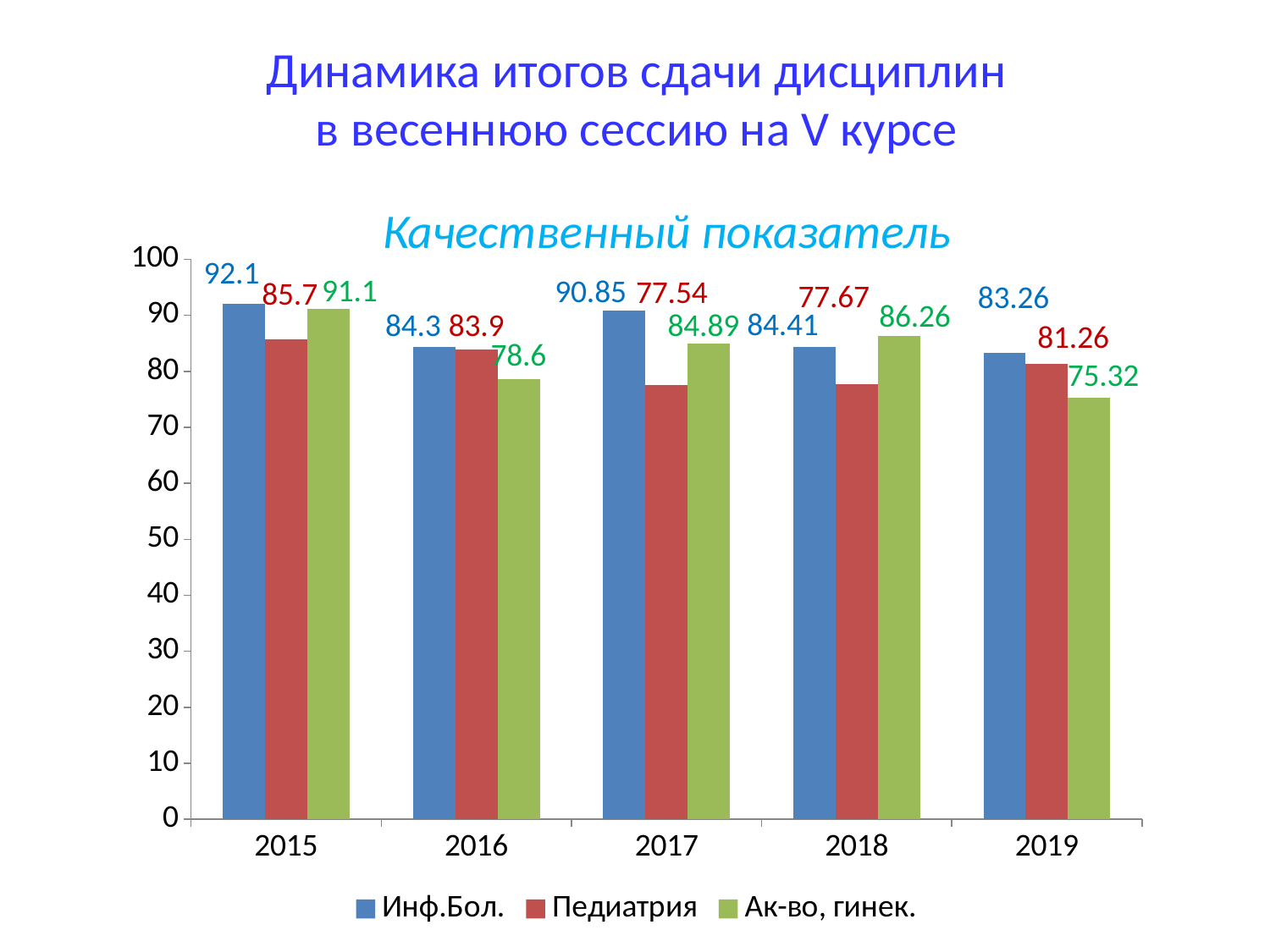
How many years are shown on the x axis? 5 What is the value for Инф.Бол. in 2015? 92.1 What is the value for Ак-во, гинек. in 2019? 75.32 In which year is the Инф.Бол. value highest? 2015 What is the difference between the Инф.Бол. and Педиатрия values in 2017? 13.31 Is the value for Педиатрия in 2019 greater or less than 80? greater In which year is the Ак-во, гинек. value lowest? 2019 What is the subtitle shown above the chart? Качественный показатель How many series does the legend list? 3 What is the value for Педиатрия in 2017? 77.54 Which is larger in 2018: the Инф.Бол. value or the Ак-во, гинек. value? Ак-во, гинек. What kind of chart is shown on the slide? bar chart